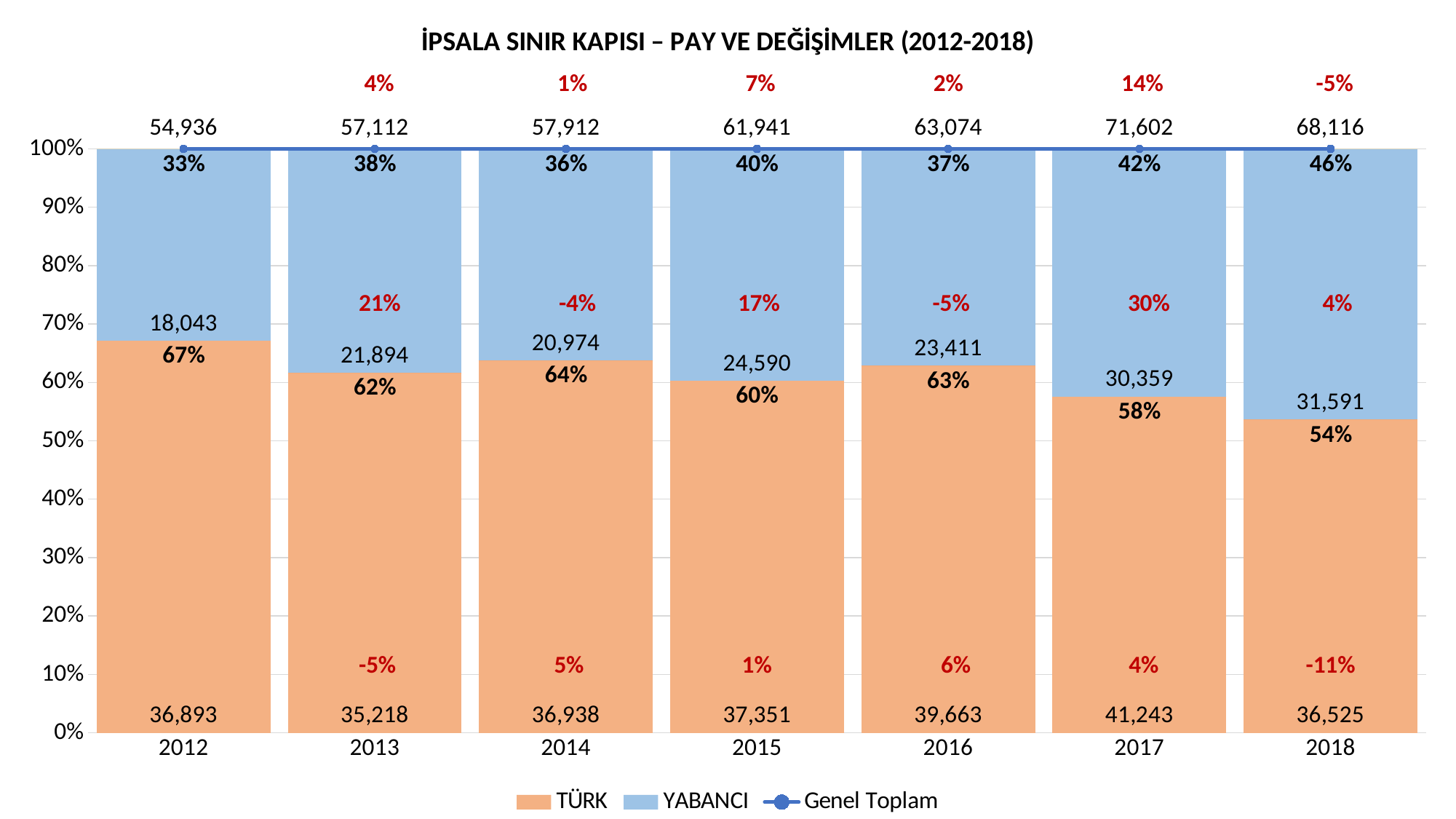
What is the YABANCI value for 2017? 30,359 What is the TÜRK value for 2015? 37,351 Which year has the highest Genel Toplam value? 2017 Which year has the lowest TÜRK value? 2013 What is the difference between the TÜRK and YABANCI values in 2012? 18,850 Which is larger, the TÜRK value in 2016 or the TÜRK value in 2017? 2017 What percentage share does YABANCI have in 2014? 36% Does the YABANCI share rise or fall overall from 2012 to 2018? Rise What is the Genel Toplam value for 2018? 68,116 What kind of chart is this? Stacked bar chart with a line How many years are shown on the x axis? 7 How many series does the legend list? 3